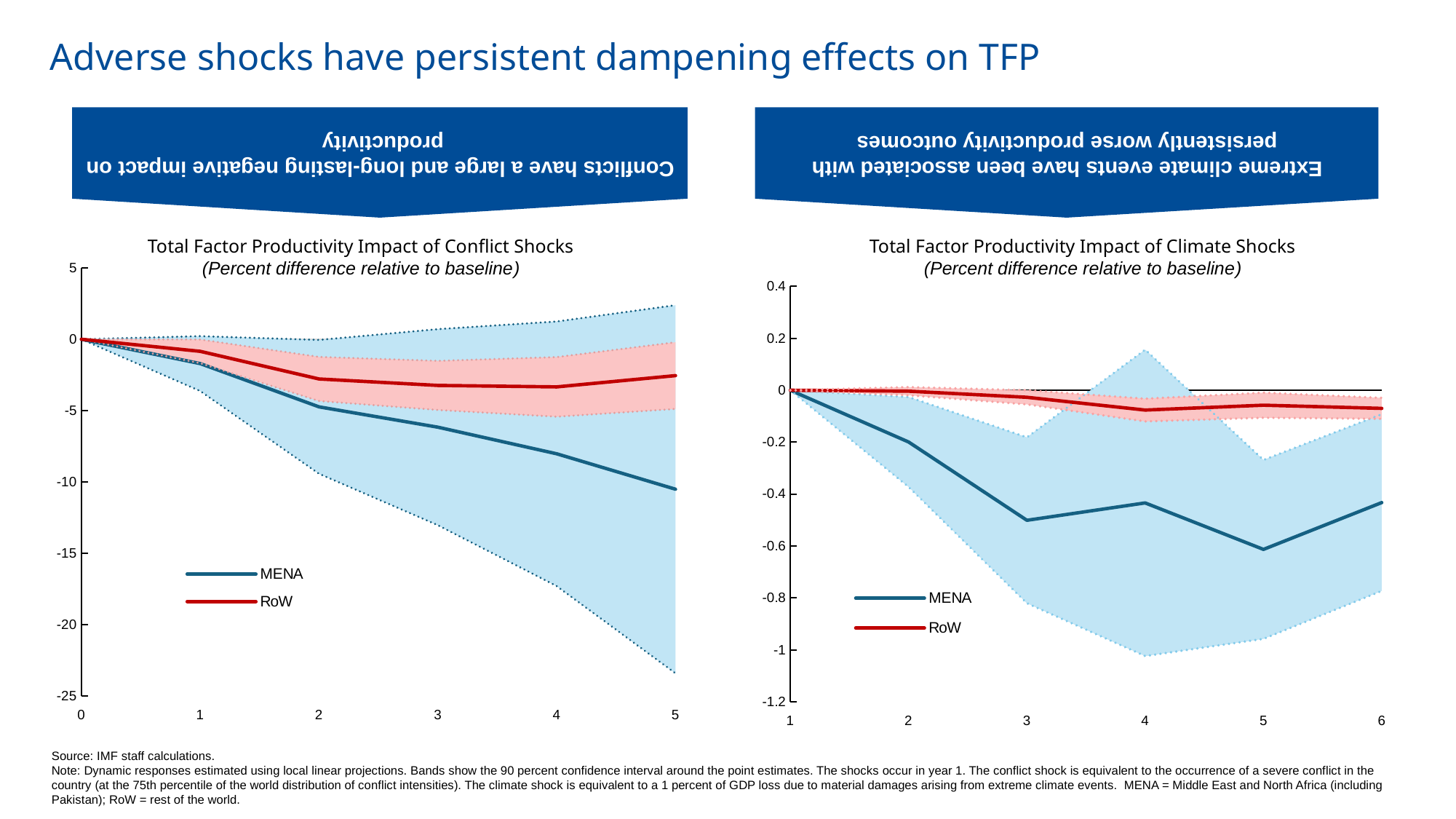
In the 'Total Factor Productivity Impact of Conflict Shocks' chart, at year 5, which series has the higher value, MENA or RoW? RoW How many series does the legend list in the 'Total Factor Productivity Impact of Climate Shocks' chart? 2 How many year points are marked on the x axis of the 'Total Factor Productivity Impact of Climate Shocks' chart? 6 In the 'Total Factor Productivity Impact of Conflict Shocks' chart, is the RoW value at year 5 greater or less than -5? greater In the 'Total Factor Productivity Impact of Climate Shocks' chart, is the MENA value at year 4 greater or less than -0.2? less In the 'Total Factor Productivity Impact of Climate Shocks' chart, at year 5, which series has the lower value, MENA or RoW? MENA In the 'Total Factor Productivity Impact of Climate Shocks' chart, is the RoW value at year 6 greater or less than -0.2? greater In the 'Total Factor Productivity Impact of Conflict Shocks' chart, which series are listed in the legend? MENA and RoW In the 'Total Factor Productivity Impact of Conflict Shocks' chart, does the MENA line rise or fall as the years increase from 0 to 5? fall What kind of chart is the 'Total Factor Productivity Impact of Conflict Shocks' chart? line chart What unit is given in the subtitle of the 'Total Factor Productivity Impact of Climate Shocks' chart? Percent difference relative to baseline